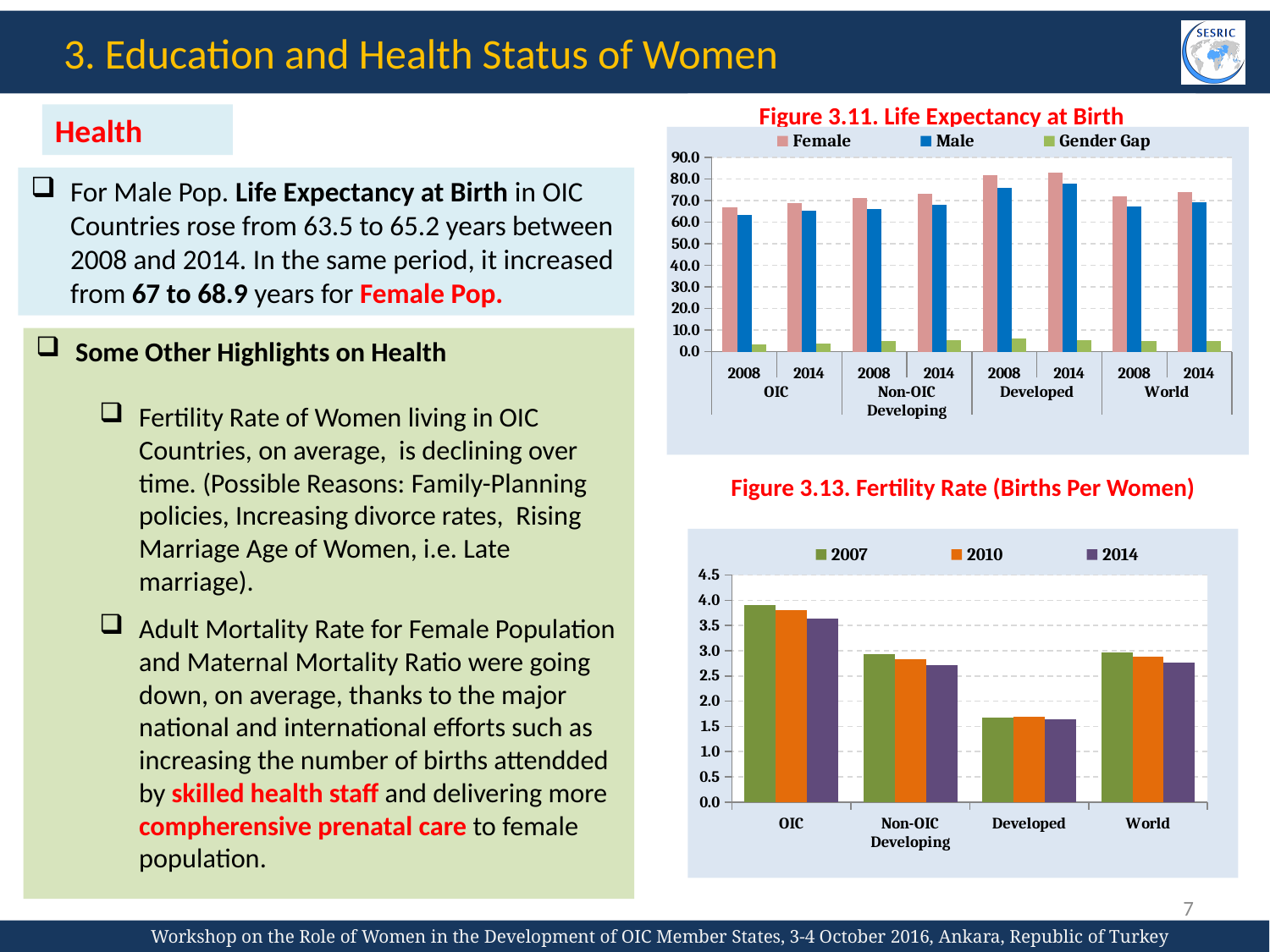
In Figure 3.13. Fertility Rate (Births Per Women), which region has the lowest fertility rate in 2014? Developed In Figure 3.11. Life Expectancy at Birth, is the Gender Gap value for Developed in 2014 greater or less than 10.0? less In Figure 3.11. Life Expectancy at Birth, which region group has the highest Female bar? Developed How many region categories are shown on the x axis of Figure 3.13. Fertility Rate (Births Per Women)? 4 In Figure 3.11. Life Expectancy at Birth, which is larger for OIC in 2014: the Female value or the Male value? Female What kind of chart is Figure 3.13. Fertility Rate (Births Per Women)? bar chart In Figure 3.11. Life Expectancy at Birth, is the Female value for Developed in 2014 greater or less than 80.0? greater What kind of chart is Figure 3.11. Life Expectancy at Birth? bar chart How many series does the legend of Figure 3.11. Life Expectancy at Birth list? 3 In Figure 3.13. Fertility Rate (Births Per Women), do the OIC values rise or fall from 2007 to 2014? fall How many series does the legend of Figure 3.13. Fertility Rate (Births Per Women) list? 3 In Figure 3.11. Life Expectancy at Birth, is the Male value for OIC in 2008 greater or less than 70.0? less